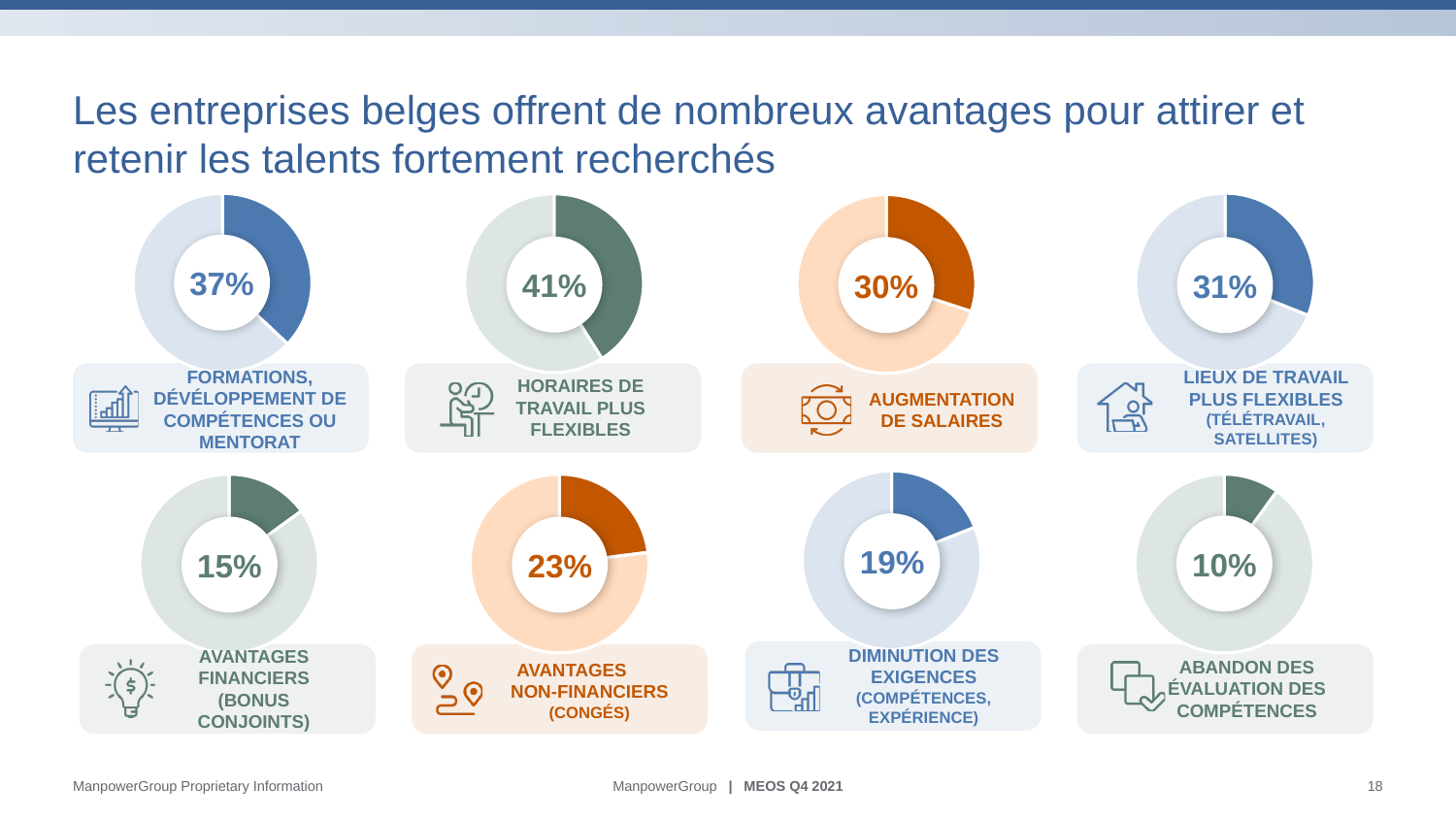
What percentage is shown in the donut chart labelled 'Formations, développement de compétences ou mentorat'? 37% What is the difference in percentage points between the 'Horaires de travail plus flexibles' chart and the 'Avantages financiers (bonus conjoints)' chart? 26 What percentage is shown in the donut chart labelled 'Diminution des exigences (compétences, expérience)'? 19% What type of chart is used for each of the eight percentages on the slide? Donut chart Across all the donut charts on the slide, which category has the lowest percentage? Abandon des évaluation des compétences How many donut charts are shown on the slide? 8 What percentage is shown in the donut chart labelled 'Horaires de travail plus flexibles'? 41% What percentage is shown in the donut chart labelled 'Augmentation de salaires'? 30% Which has a higher percentage: the 'Augmentation de salaires' chart or the 'Avantages non-financiers (congés)' chart? Augmentation de salaires Across all the donut charts on the slide, which category has the highest percentage? Horaires de travail plus flexibles What percentage is shown in the donut chart labelled 'Avantages non-financiers (congés)'? 23% What percentage is shown in the donut chart labelled 'Lieux de travail plus flexibles (télétravail, satellites)'? 31%